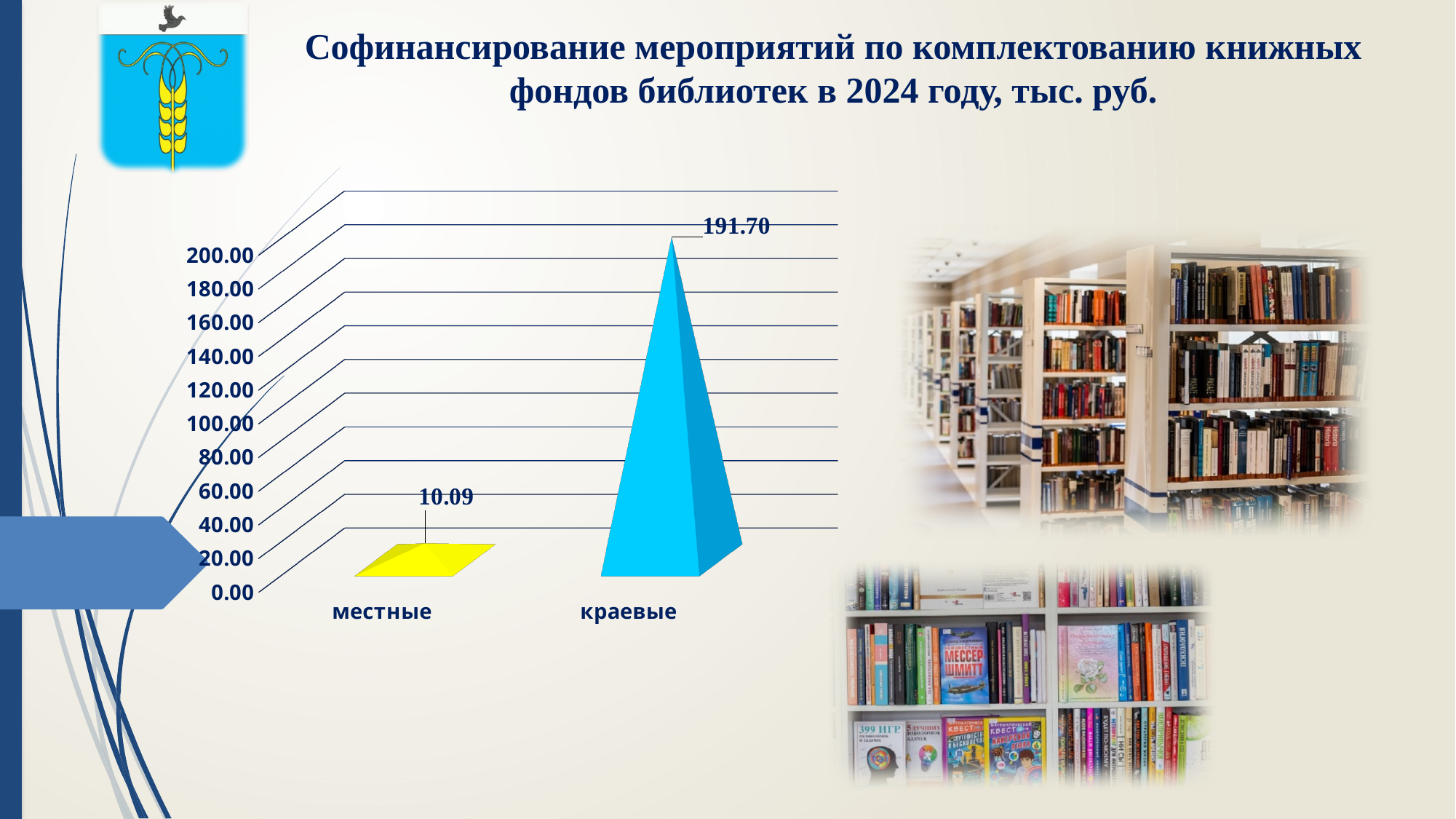
Which category has the lowest value? местные Is the value for краевые greater or less than 180.00? greater What is the value for краевые? 191.70 What kind of chart is shown on the slide? bar chart Which is larger, the value for местные or the value for краевые? краевые What is the highest tick value shown on the vertical axis? 200.00 What is the total of the two values shown on the chart? 201.79 How many categories are shown on the chart? 2 What is the difference between the values for краевые and местные? 181.61 What is the value for местные? 10.09 Is the value for местные greater or less than 20.00? less Which category has the highest value? краевые